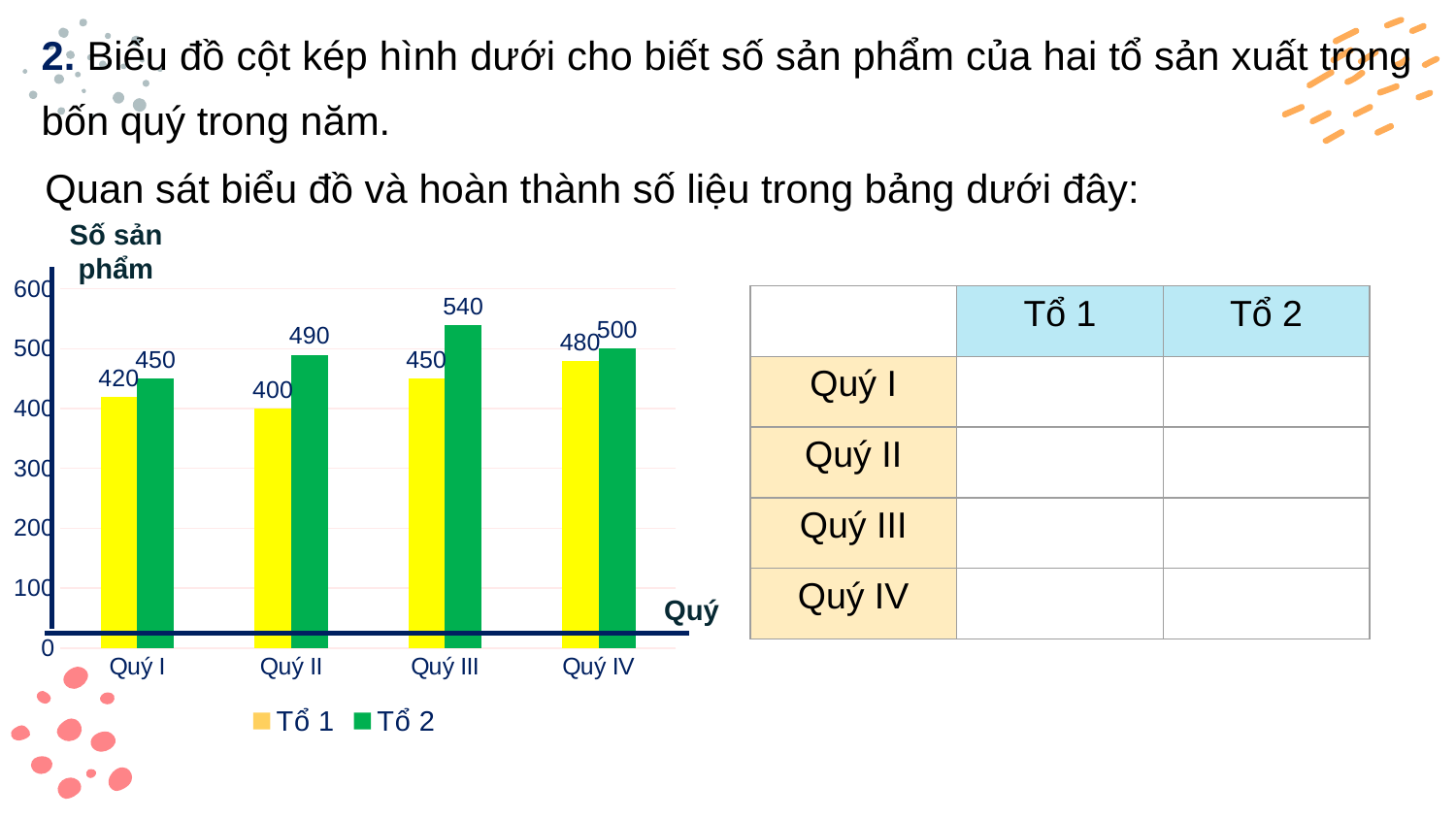
How many quarters are shown on the x axis? 4 What is the value for Tổ 1 in Quý IV? 480 What colour are the bars for Tổ 2? Green What is the value for Tổ 1 in Quý I? 420 How many series does the legend list? 2 What is the value for Tổ 2 in Quý II? 490 What kind of chart is shown on the slide? Bar chart Which is larger in Quý IV, Tổ 1 or Tổ 2? Tổ 2 In which quarter does Tổ 1 have its lowest value? Quý II What is the difference between Tổ 2 and Tổ 1 in Quý III? 90 What is the value for Tổ 2 in Quý III? 540 In which quarter does Tổ 2 have its highest value? Quý III